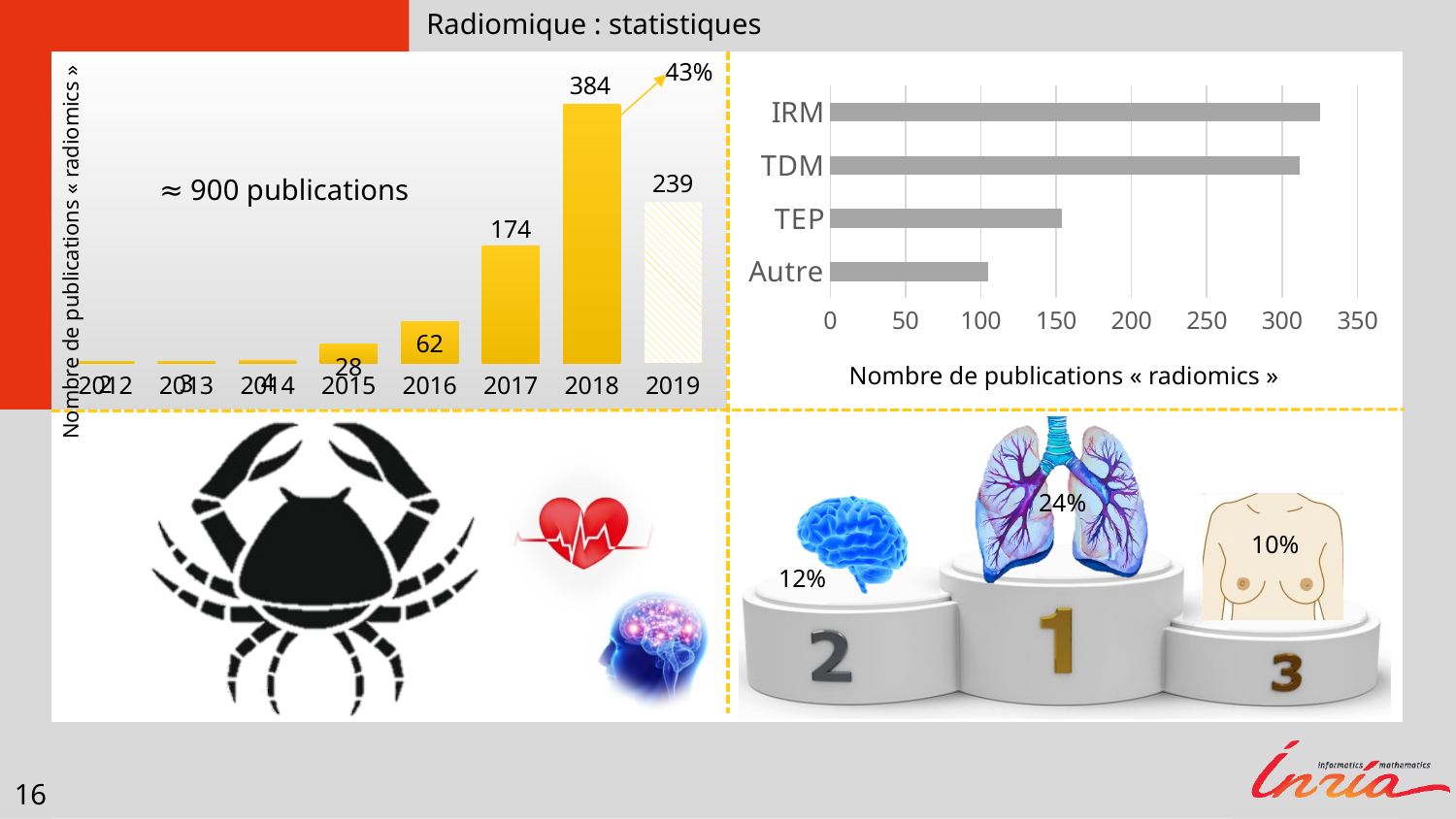
In the left bar chart, which year has the highest value? 2018 In the left bar chart, what is the value for 2015? 28 In the left bar chart, what is the difference between the values for 2018 and 2017? 210 In the right chart, is the value for IRM greater or less than 300? greater What kind of chart is the right chart? bar chart In the right chart, is the value for TEP greater or less than 200? less In the left bar chart, what is the value for 2016? 62 In the left bar chart, how many years are shown on the x axis? 8 In the left bar chart, what is the value for 2018? 384 In the left bar chart, what is the value for 2017? 174 In the right chart, which category has the lowest value? Autre In the left bar chart, which is larger, the value for 2019 or the value for 2017? 2019